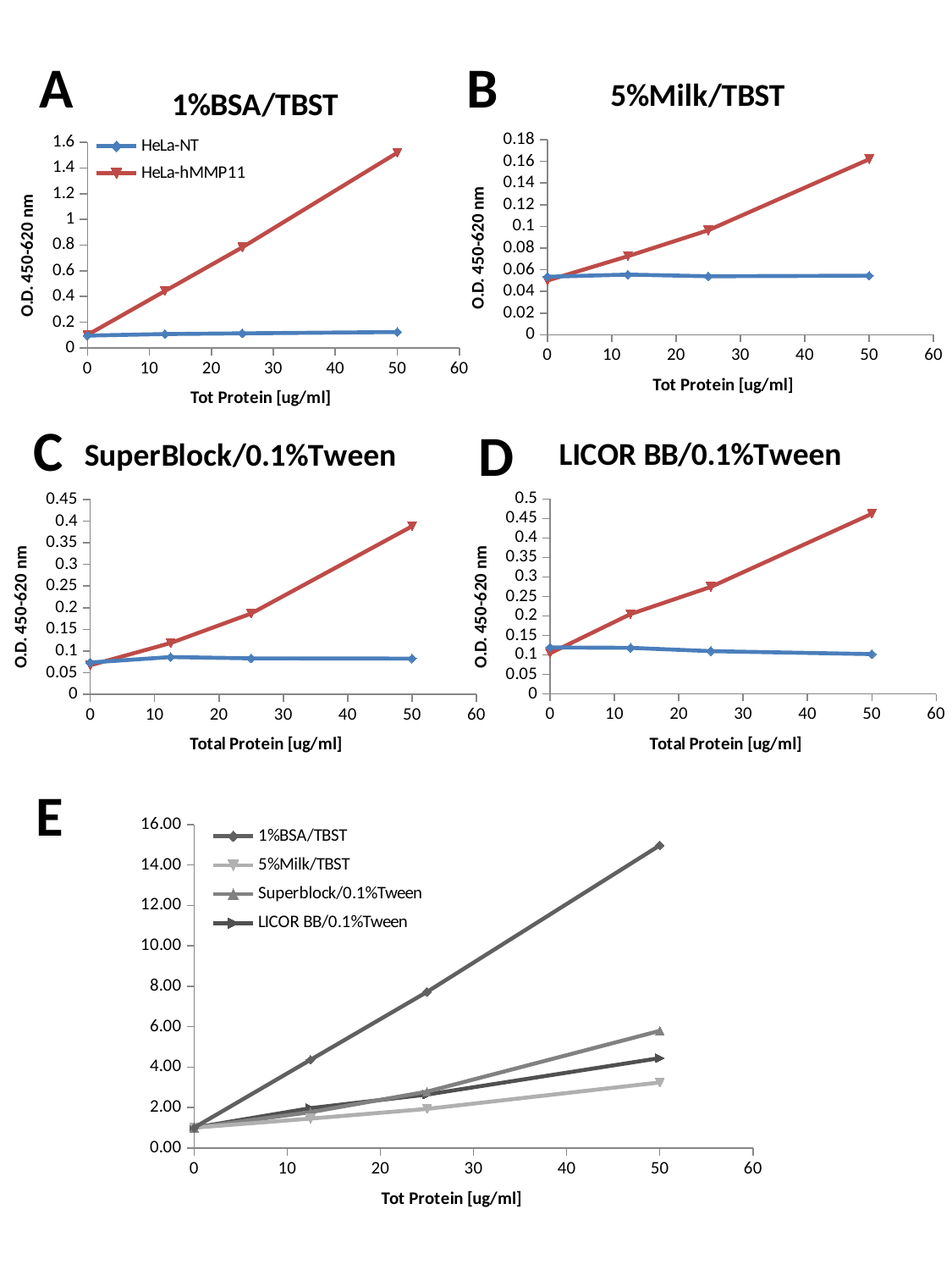
In chart D (LICOR BB/0.1%Tween), which series is higher at 50 ug/ml, HeLa-NT or HeLa-hMMP11? HeLa-hMMP11 In chart A (1%BSA/TBST), is the HeLa-NT value at 50 ug/ml greater or less than 0.2? less In chart E (bottom chart), which series has the lowest value at 50 ug/ml? 5%Milk/TBST In chart E (bottom chart), how many series does the legend list? 4 In chart A (1%BSA/TBST), is the HeLa-hMMP11 value at 50 ug/ml greater or less than 1.4? greater In chart E (bottom chart), is the 1%BSA/TBST value at 50 ug/ml greater or less than 14.00? greater In chart A (1%BSA/TBST), how many series does the legend list? 2 In chart B (5%Milk/TBST), does the HeLa-hMMP11 series rise or fall as Tot Protein increases? rise In chart E (bottom chart), which series has the highest value at 50 ug/ml? 1%BSA/TBST What kind of chart is chart A (1%BSA/TBST)? line chart